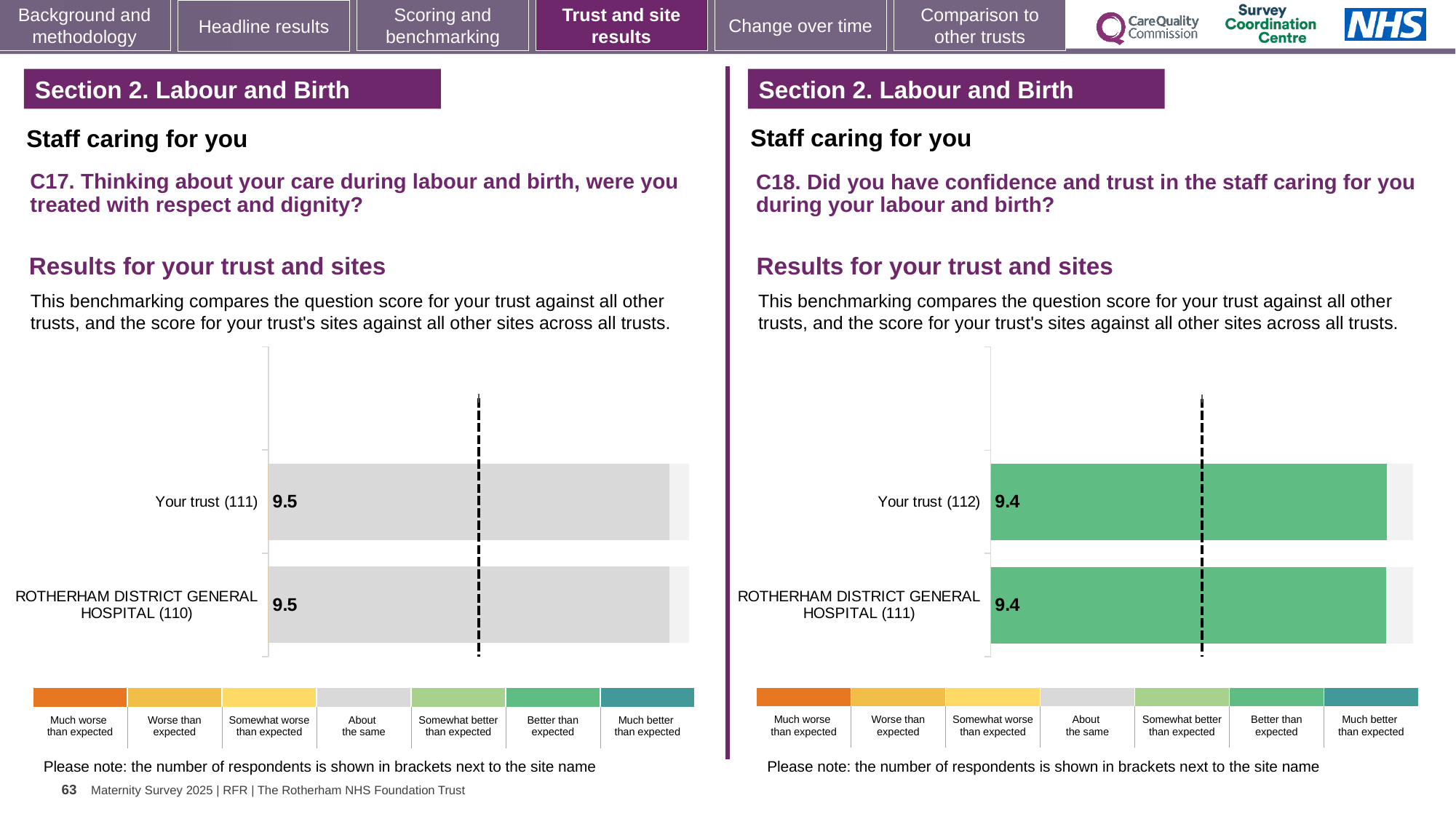
In the C18 chart on the right, what is the difference between the score for Your trust and the score for ROTHERHAM DISTRICT GENERAL HOSPITAL? 0 In the C17 chart on the left, what is the score for Your trust (111)? 9.5 In the C18 chart on the right, what is the score for ROTHERHAM DISTRICT GENERAL HOSPITAL (111)? 9.4 In the C18 chart on the right, which benchmark category does the colour of the bars correspond to? Better than expected In the C17 chart on the left, what is the difference between the score for Your trust and the score for ROTHERHAM DISTRICT GENERAL HOSPITAL? 0 In the C18 chart on the right, what is the score for Your trust (112)? 9.4 How many bars are plotted in the C18 chart on the right? 2 How many respondents are shown in brackets for Your trust in the C18 chart on the right? 112 What type of chart is used for the C17 results on the left? Bar chart How many bars are plotted in the C17 chart on the left? 2 In the C17 chart on the left, what is the score for ROTHERHAM DISTRICT GENERAL HOSPITAL (110)? 9.5 In the C17 chart on the left, which benchmark category does the colour of the bars correspond to? About the same